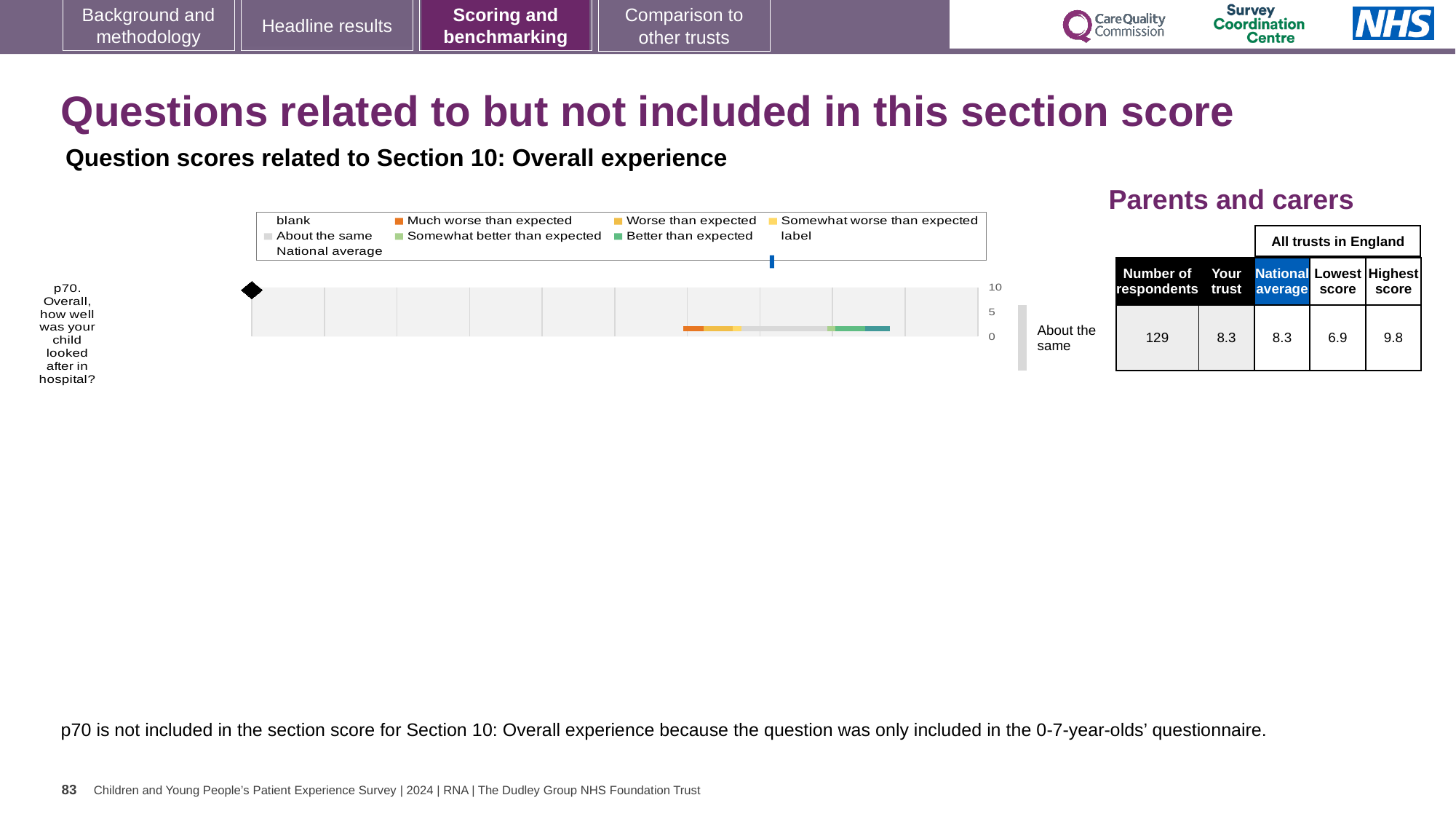
What is the highest score among all trusts in England for p70? 9.8 What is the lowest score among all trusts in England for p70? 6.9 What colour represents 'Much worse than expected' in the legend? orange What is the national average score for p70? 8.3 How many questions are plotted in the chart? 1 Which question is plotted in the chart? p70. Overall, how well was your child looked after in hospital? Is the 'Your trust' score for p70 greater or less than the lowest score across all trusts? greater What category label is shown to the right of the bar for p70? About the same How many respondents answered p70? 129 What is the difference between the highest and lowest scores for p70 across all trusts in England? 2.9 What kind of chart is shown on the slide? bar chart What is the 'Your trust' score for p70 in the table? 8.3